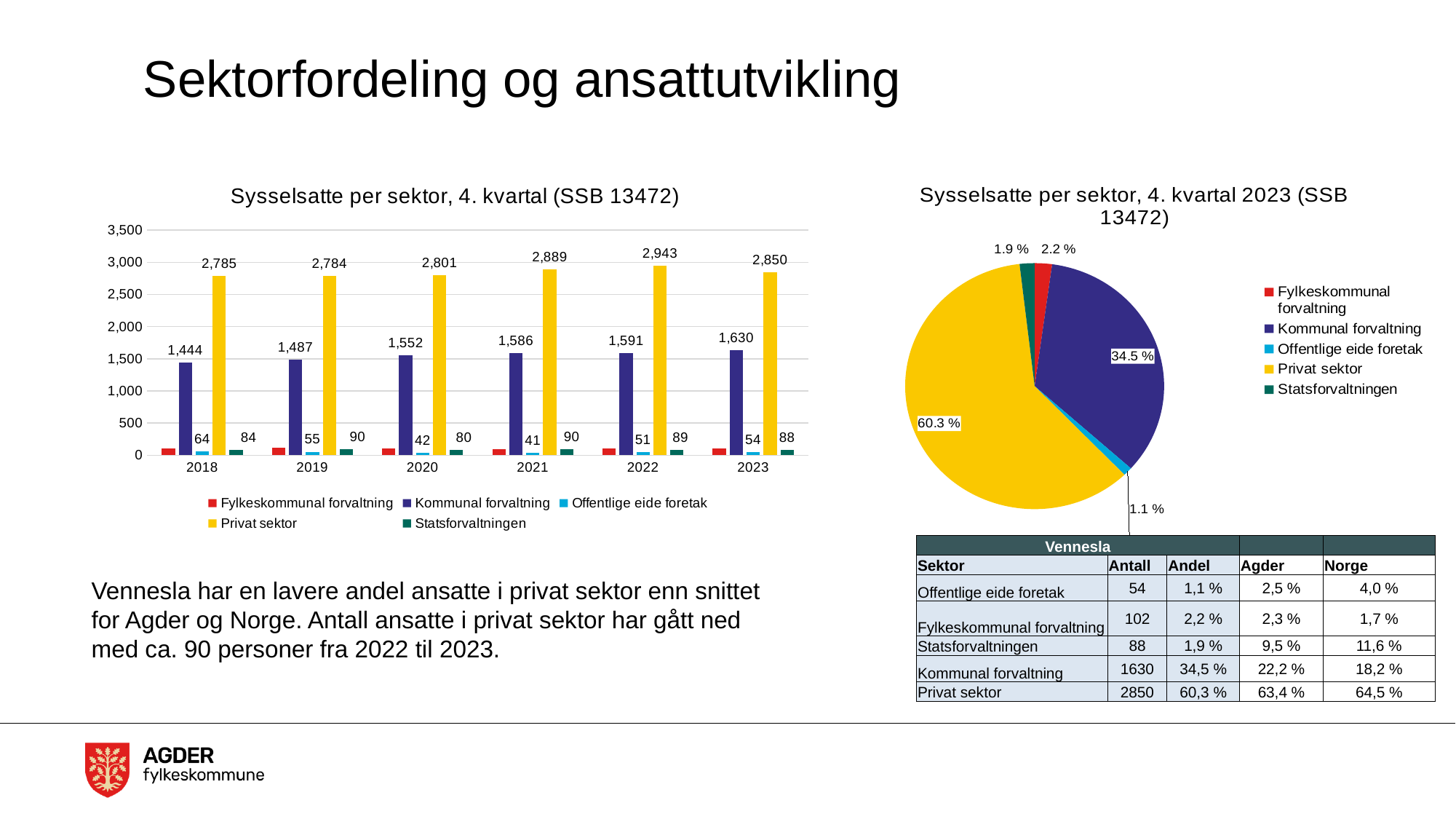
In the pie chart 'Sysselsatte per sektor, 4. kvartal 2023 (SSB 13472)', which sector has the smallest slice? Offentlige eide foretak What kind of chart is the chart on the right of the slide? pie chart In the bar chart 'Sysselsatte per sektor, 4. kvartal (SSB 13472)', which is larger in 2019: Statsforvaltningen or Offentlige eide foretak? Statsforvaltningen In the pie chart 'Sysselsatte per sektor, 4. kvartal 2023 (SSB 13472)', what share does Privat sektor have? 60.3 % In the bar chart 'Sysselsatte per sektor, 4. kvartal (SSB 13472)', how many series does the legend list? 5 In the bar chart 'Sysselsatte per sektor, 4. kvartal (SSB 13472)', what is the value for Kommunal forvaltning in 2018? 1,444 In the bar chart 'Sysselsatte per sektor, 4. kvartal (SSB 13472)', does Kommunal forvaltning rise or fall from 2018 to 2023? rise In the bar chart 'Sysselsatte per sektor, 4. kvartal (SSB 13472)', what is the value for Privat sektor in 2022? 2,943 In the bar chart 'Sysselsatte per sektor, 4. kvartal (SSB 13472)', by how much did Privat sektor change from 2022 to 2023? -93 In the bar chart 'Sysselsatte per sektor, 4. kvartal (SSB 13472)', what is the value for Offentlige eide foretak in 2021? 41 In the bar chart 'Sysselsatte per sektor, 4. kvartal (SSB 13472)', in which year is Privat sektor highest? 2022 In the bar chart 'Sysselsatte per sektor, 4. kvartal (SSB 13472)', how many years are shown on the x axis? 6